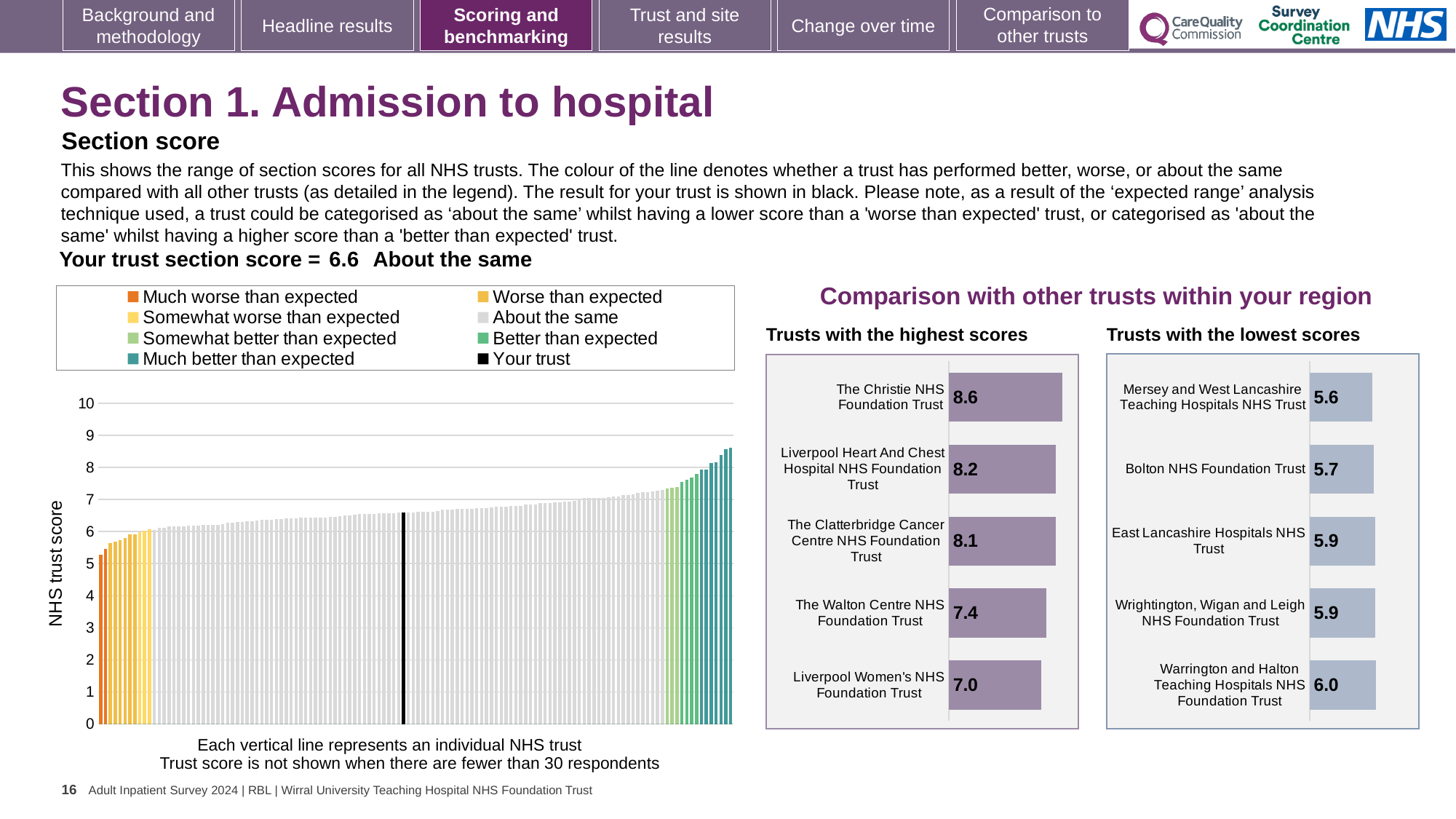
In the 'Trusts with the lowest scores' chart, which trust has the lowest score? Mersey and West Lancashire Teaching Hospitals NHS Trust In the 'Trusts with the highest scores' chart, which trust has the lowest score shown? Liverpool Women's NHS Foundation Trust In the 'Trusts with the highest scores' chart, what is the score for The Walton Centre NHS Foundation Trust? 7.4 In the large chart on the left showing NHS trust scores, do the values rise or fall from left to right? rise In the 'Trusts with the lowest scores' chart, what is the score for Bolton NHS Foundation Trust? 5.7 In the 'Trusts with the highest scores' chart, what is the score for The Christie NHS Foundation Trust? 8.6 In the 'Trusts with the highest scores' chart, which has the higher score: Liverpool Heart And Chest Hospital NHS Foundation Trust or The Clatterbridge Cancer Centre NHS Foundation Trust? Liverpool Heart And Chest Hospital NHS Foundation Trust In the large chart on the left showing NHS trust scores, what is the section score for your trust (the black line)? 6.6 In the 'Trusts with the lowest scores' chart, what is the difference between the scores of Warrington and Halton Teaching Hospitals NHS Foundation Trust and Mersey and West Lancashire Teaching Hospitals NHS Trust? 0.4 In the 'Trusts with the highest scores' chart, what is the difference between the scores of The Christie NHS Foundation Trust and Liverpool Women's NHS Foundation Trust? 1.6 How many entries does the legend of the large chart on the left list? 8 How many trusts are listed in the 'Trusts with the lowest scores' chart? 5